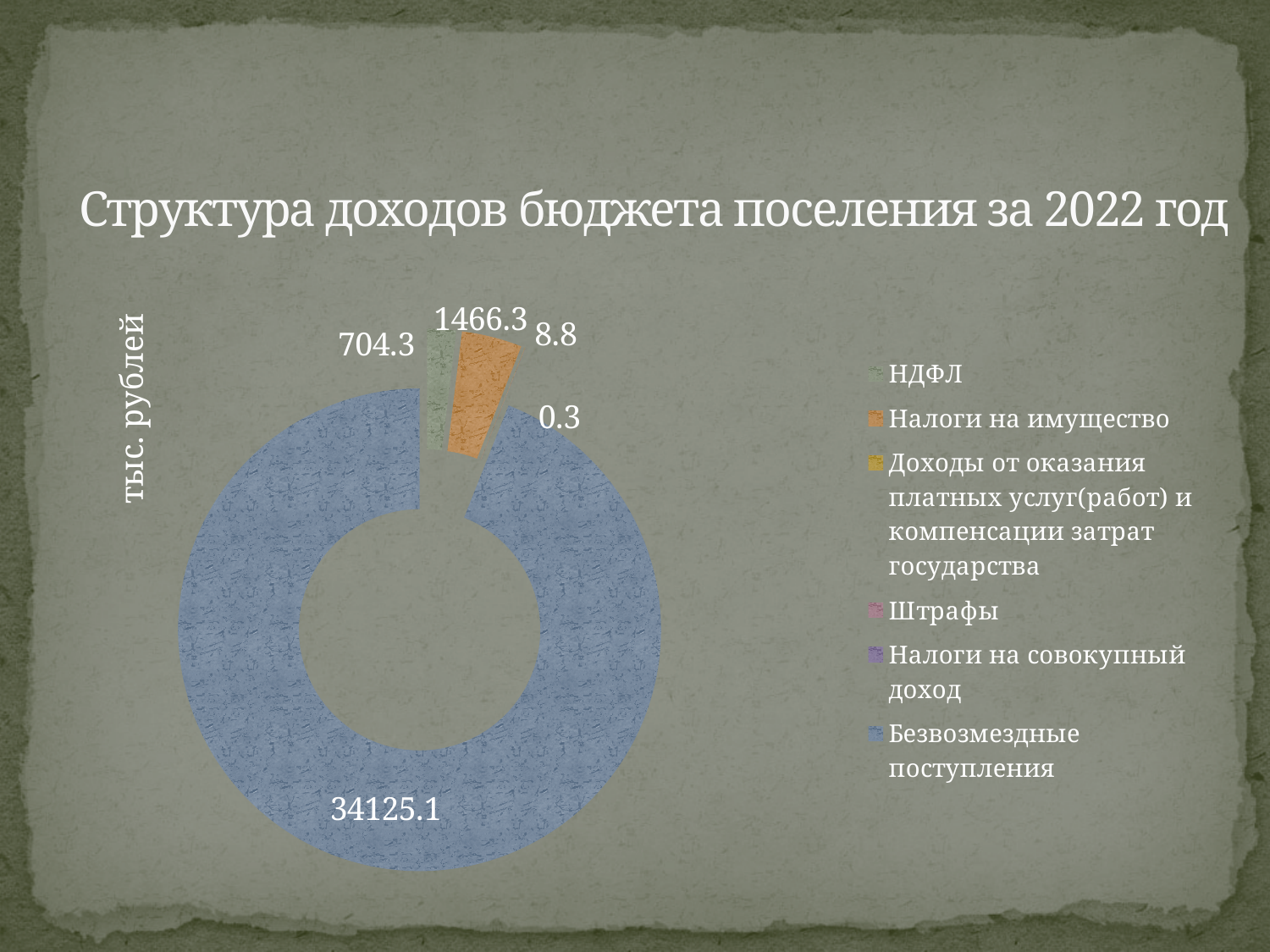
What is the smallest data label printed on the chart? 0.3 What is the title of the chart? Структура доходов бюджета поселения за 2022 год Which category has the largest slice of the chart? Безвозмездные поступления What is the value for НДФЛ? 704.3 What is the value for Безвозмездные поступления? 34125.1 How many entries does the chart legend list? 6 What is the value for Налоги на имущество? 1466.3 What unit is indicated by the vertical text label next to the chart? тыс. рублей What is the difference between the values for Налоги на имущество and НДФЛ? 762.0 What kind of chart is shown on the slide? Doughnut (pie) chart Which is larger, Налоги на имущество or НДФЛ? Налоги на имущество